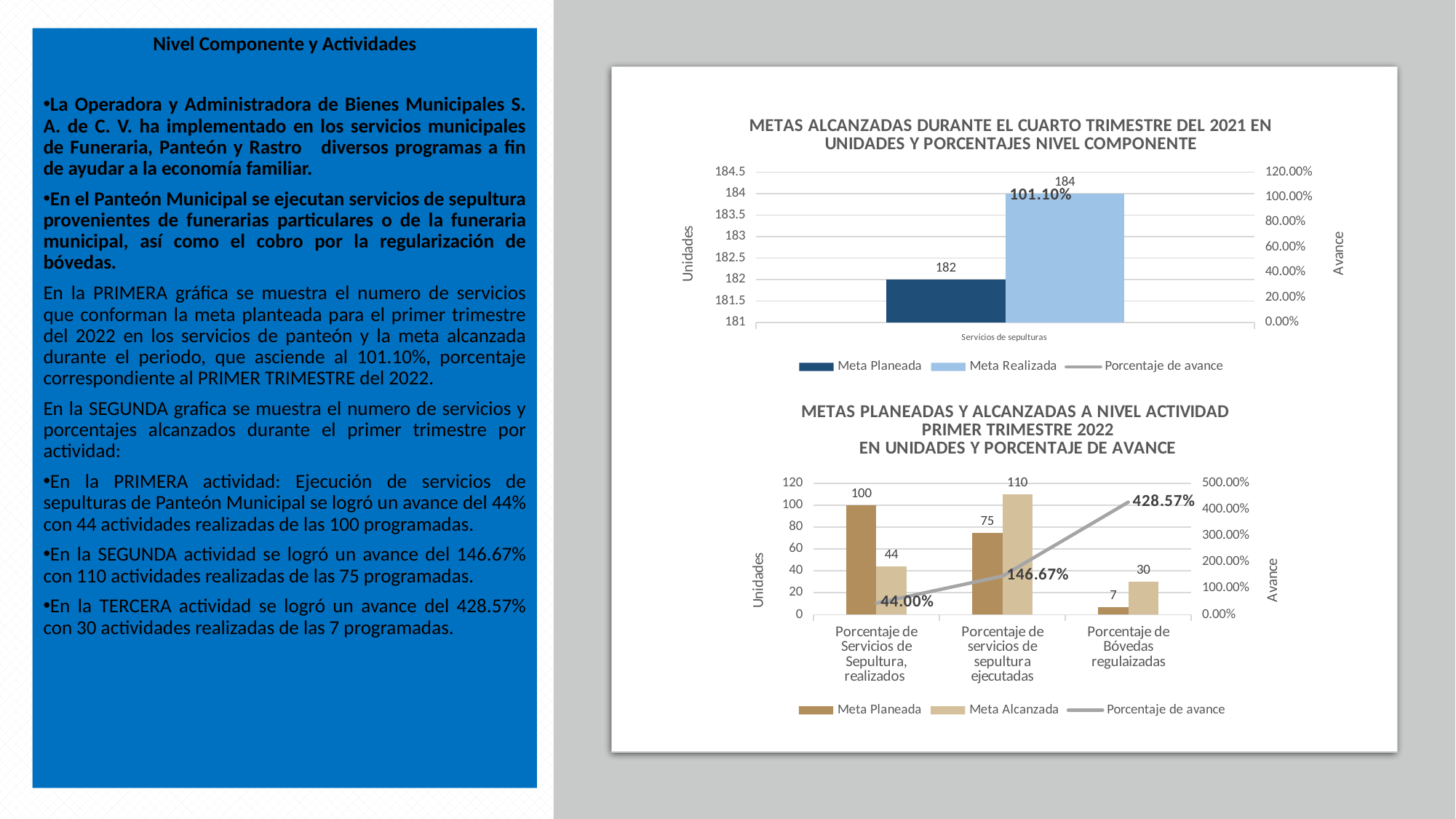
In the top chart, how many series does the legend list? 3 In the top chart, what is the value of Meta Realizada for Servicios de sepulturas? 184 In the top chart, what is the Porcentaje de avance shown? 101.10% In the bottom chart (METAS PLANEADAS Y ALCANZADAS A NIVEL ACTIVIDAD), what is the Meta Alcanzada for Porcentaje de Servicios de Sepultura, realizados? 44 In the bottom chart, what is the Porcentaje de avance for Porcentaje de Bóvedas regulaizadas? 428.57% In the bottom chart, what is the difference between Meta Planeada and Meta Alcanzada for Porcentaje de Servicios de Sepultura, realizados? 56 In the bottom chart, how many categories are shown on the x axis? 3 In the top chart, what is the difference between Meta Realizada and Meta Planeada? 2 In the top chart (METAS ALCANZADAS DURANTE EL CUARTO TRIMESTRE DEL 2021), what is the value of Meta Planeada for Servicios de sepulturas? 182 In the bottom chart, which category has the lowest Meta Planeada? Porcentaje de Bóvedas regulaizadas In the bottom chart, which category has the highest Meta Alcanzada? Porcentaje de servicios de sepultura ejecutadas In the bottom chart, what is the Meta Planeada for Porcentaje de servicios de sepultura ejecutadas? 75